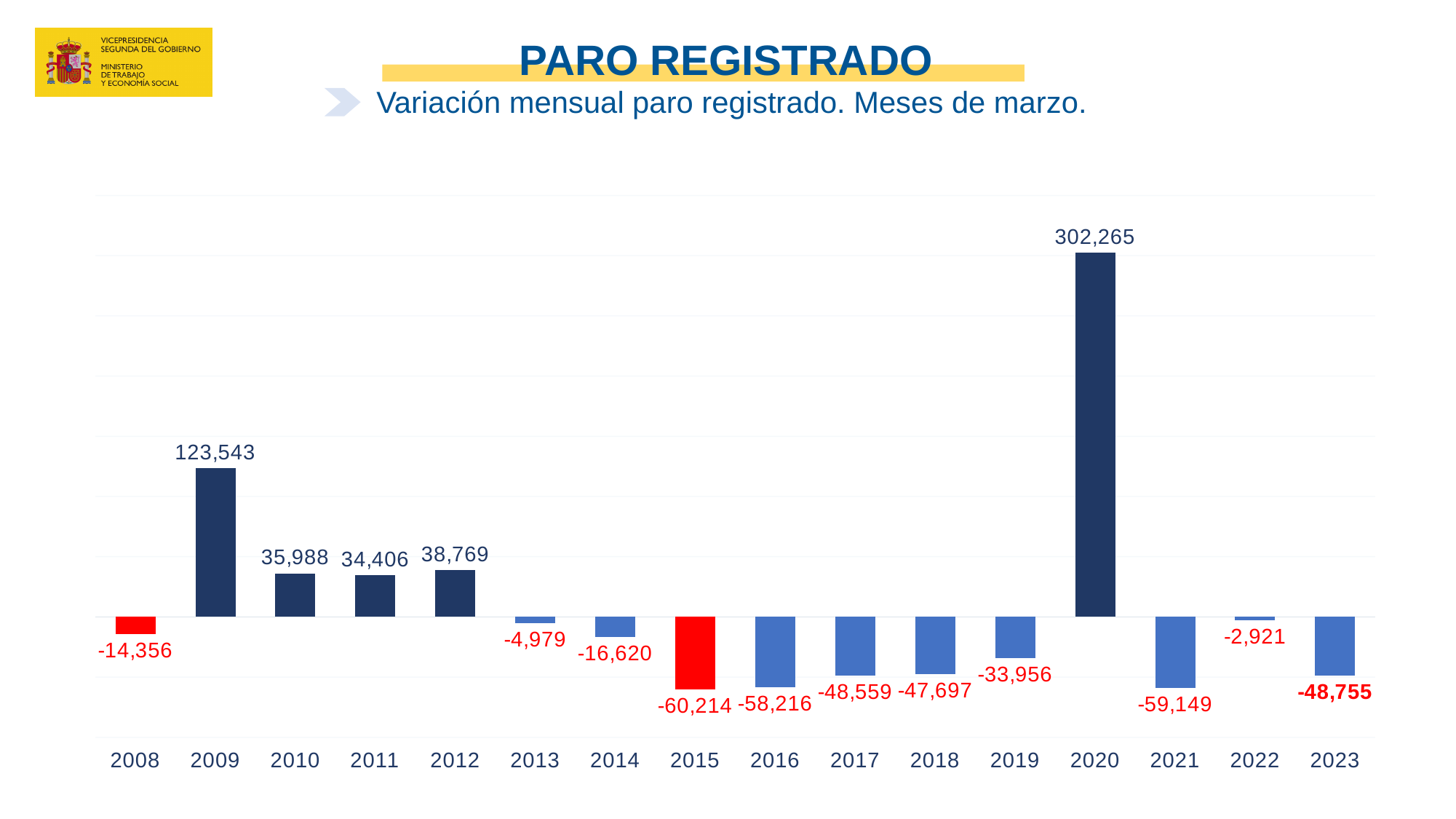
Which is larger, the value for 2010 or the value for 2012? 2012 How many years are shown on the x axis? 16 What is the difference between the values for 2020 and 2009? 178,722 What is the value shown for 2015? -60,214 What is the value shown for 2020? 302,265 What is the value shown for 2023? -48,755 What is the value shown for 2009? 123,543 What is the subtitle of the chart? Variación mensual paro registrado. Meses de marzo. Which year has the highest value? 2020 What kind of chart is shown on the slide? Bar chart Which year has the lowest value? 2015 How many years show a positive value? 5